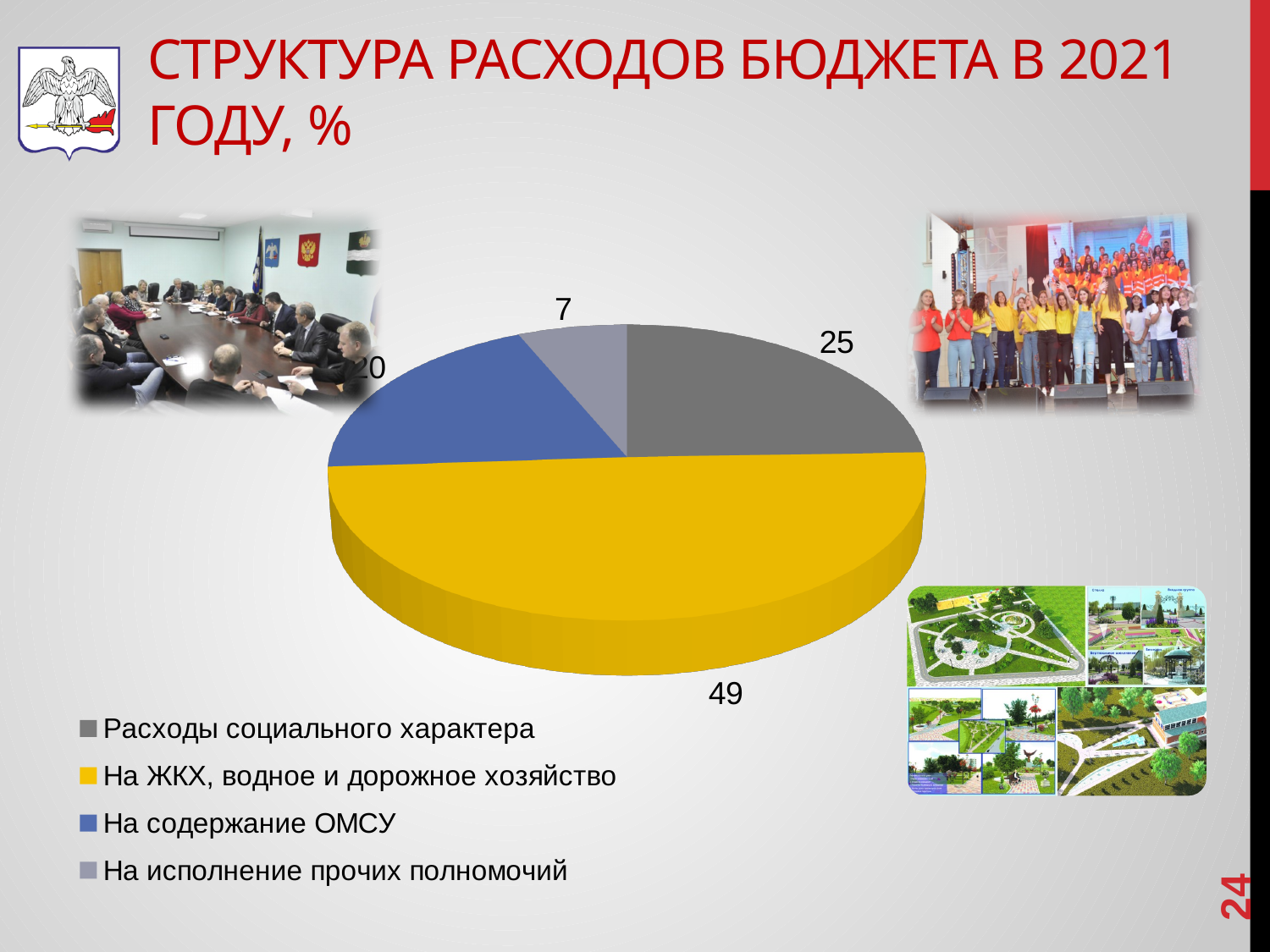
What is the value for "На исполнение прочих полномочий"? 7 Which category has the largest share of the pie? На ЖКХ, водное и дорожное хозяйство How many categories does the pie chart have? 4 Which is larger: "Расходы социального характера" or "На исполнение прочих полномочий"? Расходы социального характера Which category has the smallest share of the pie? На исполнение прочих полномочий What colour is the slice for "На ЖКХ, водное и дорожное хозяйство"? yellow What kind of chart is shown on the slide? pie chart What is the title of the slide containing the chart? СТРУКТУРА РАСХОДОВ БЮДЖЕТА В 2021 ГОДУ, % What is the value for "На ЖКХ, водное и дорожное хозяйство"? 49 What is the value for "Расходы социального характера"? 25 What is the difference between the values for "Расходы социального характера" and "На исполнение прочих полномочий"? 18 What is the difference between the values for "На ЖКХ, водное и дорожное хозяйство" and "Расходы социального характера"? 24